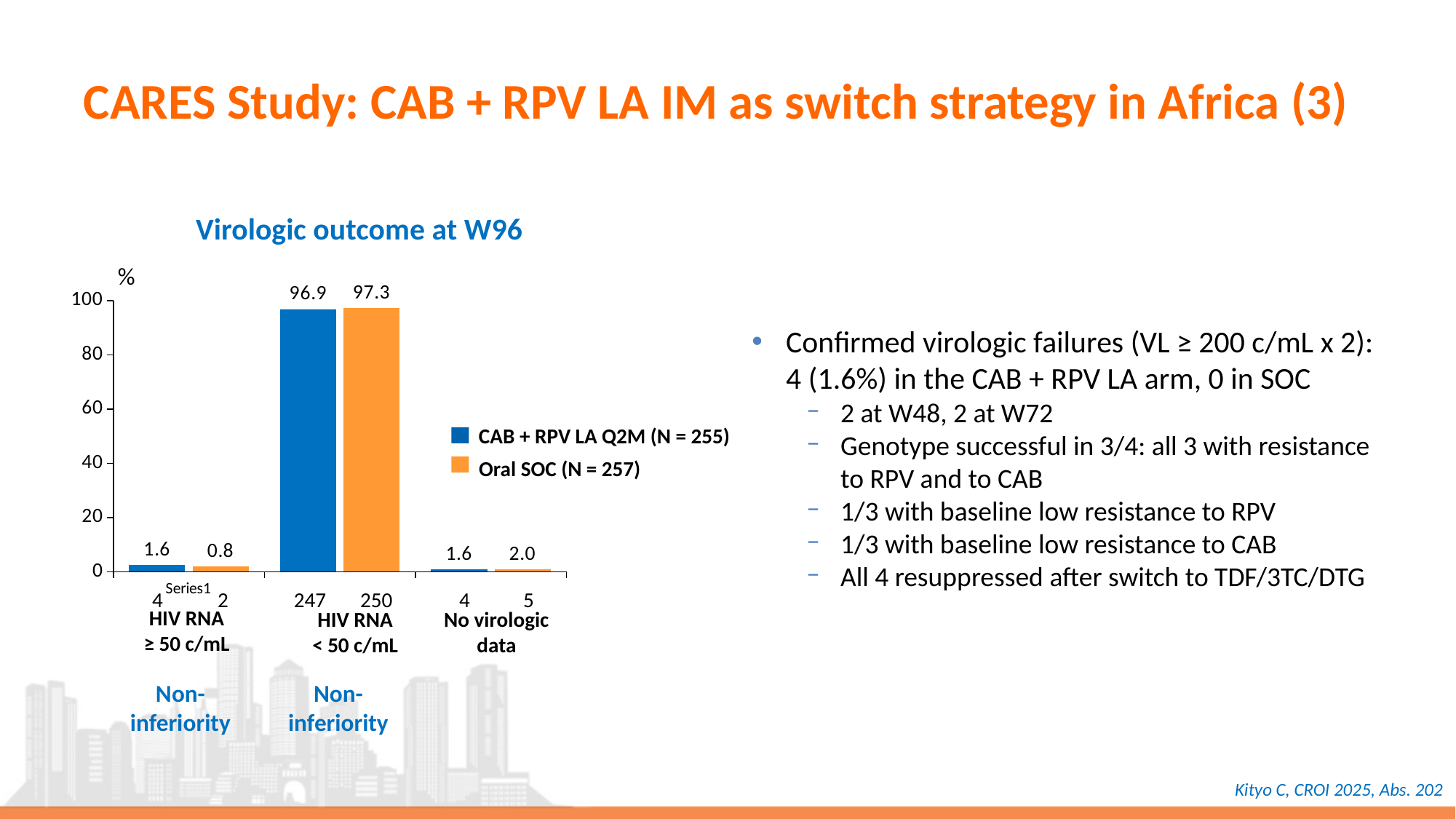
What is the difference between the CAB + RPV LA Q2M and Oral SOC values in the HIV RNA ≥ 50 c/mL category? 0.8 What is the value for Oral SOC in the HIV RNA < 50 c/mL category? 97.3 In the HIV RNA ≥ 50 c/mL category, which series has the larger value? CAB + RPV LA Q2M What is the title of the chart? Virologic outcome at W96 Which category has the highest values for both series? HIV RNA < 50 c/mL What is the value for CAB + RPV LA Q2M in the HIV RNA ≥ 50 c/mL category? 1.6 What is the value for Oral SOC in the No virologic data category? 2.0 What kind of chart is shown on the slide? Bar chart Is the value for Oral SOC in the HIV RNA < 50 c/mL category greater or less than 80? greater What is the value for CAB + RPV LA Q2M in the HIV RNA < 50 c/mL category? 96.9 How many series does the legend list? 2 What is the difference between the Oral SOC and CAB + RPV LA Q2M values in the HIV RNA < 50 c/mL category? 0.4